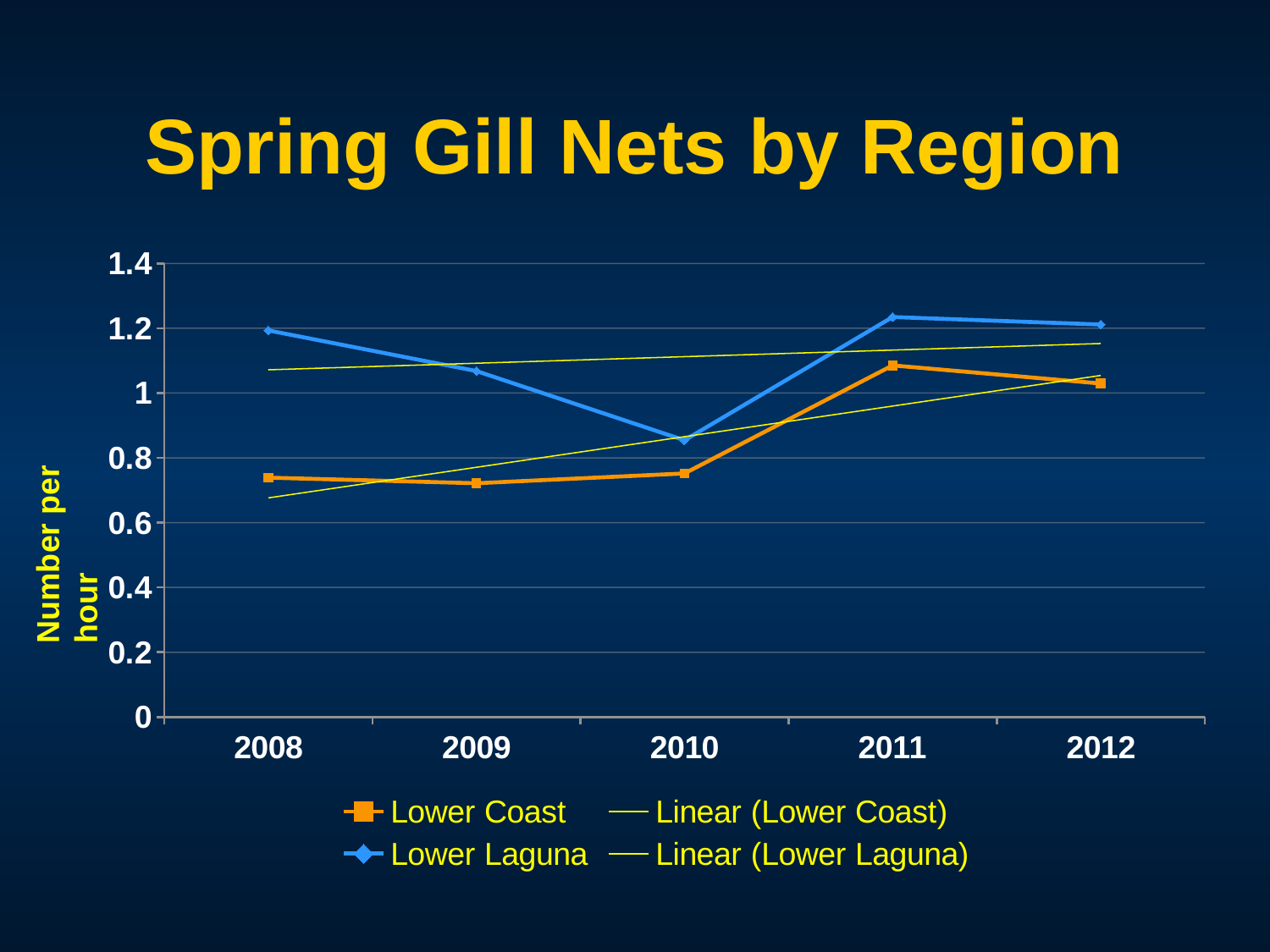
In which year is the Lower Laguna value lowest? 2010 Is the Lower Coast value for 2011 greater or less than 1? greater Is the Lower Coast value for 2008 greater or less than 0.8? less In 2010, which series has the larger value, Lower Coast or Lower Laguna? Lower Laguna How many years are plotted along the x axis? 5 Is the Lower Laguna value for 2008 greater or less than 1? greater What kind of chart is shown on the slide? Line chart Does the Lower Laguna line rise or fall from 2008 to 2010? Fall How many entries does the legend list? 4 In which year is the Lower Coast value highest? 2011 What is the label on the vertical axis? Number per hour